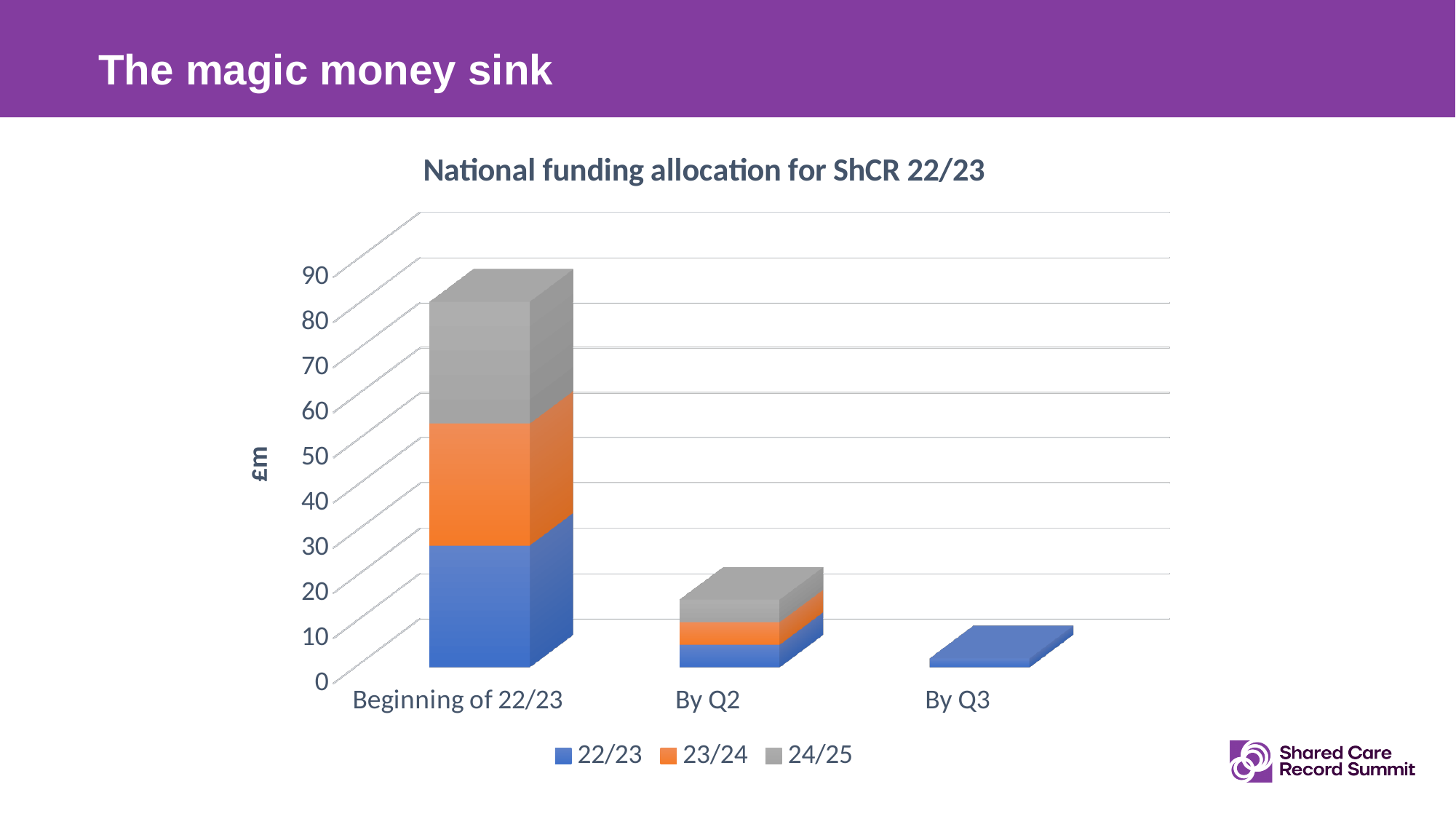
Is the total value for By Q2 greater or less than 30? less Is the total value for By Q3 greater or less than 10? less Which category has the highest total funding allocation? Beginning of 22/23 What is the title of the chart? National funding allocation for ShCR 22/23 How many series does the chart's legend list? 3 What kind of chart is shown on the slide? Stacked bar chart How many categories are shown on the x axis of the chart? 3 Is the total value for Beginning of 22/23 greater or less than 50? greater Which category has the lowest total funding allocation? By Q3 Which is larger, the 22/23 series value at Beginning of 22/23 or at By Q2? Beginning of 22/23 What unit is shown on the y axis label of the chart? £m Do the total values rise or fall from Beginning of 22/23 to By Q3? Fall